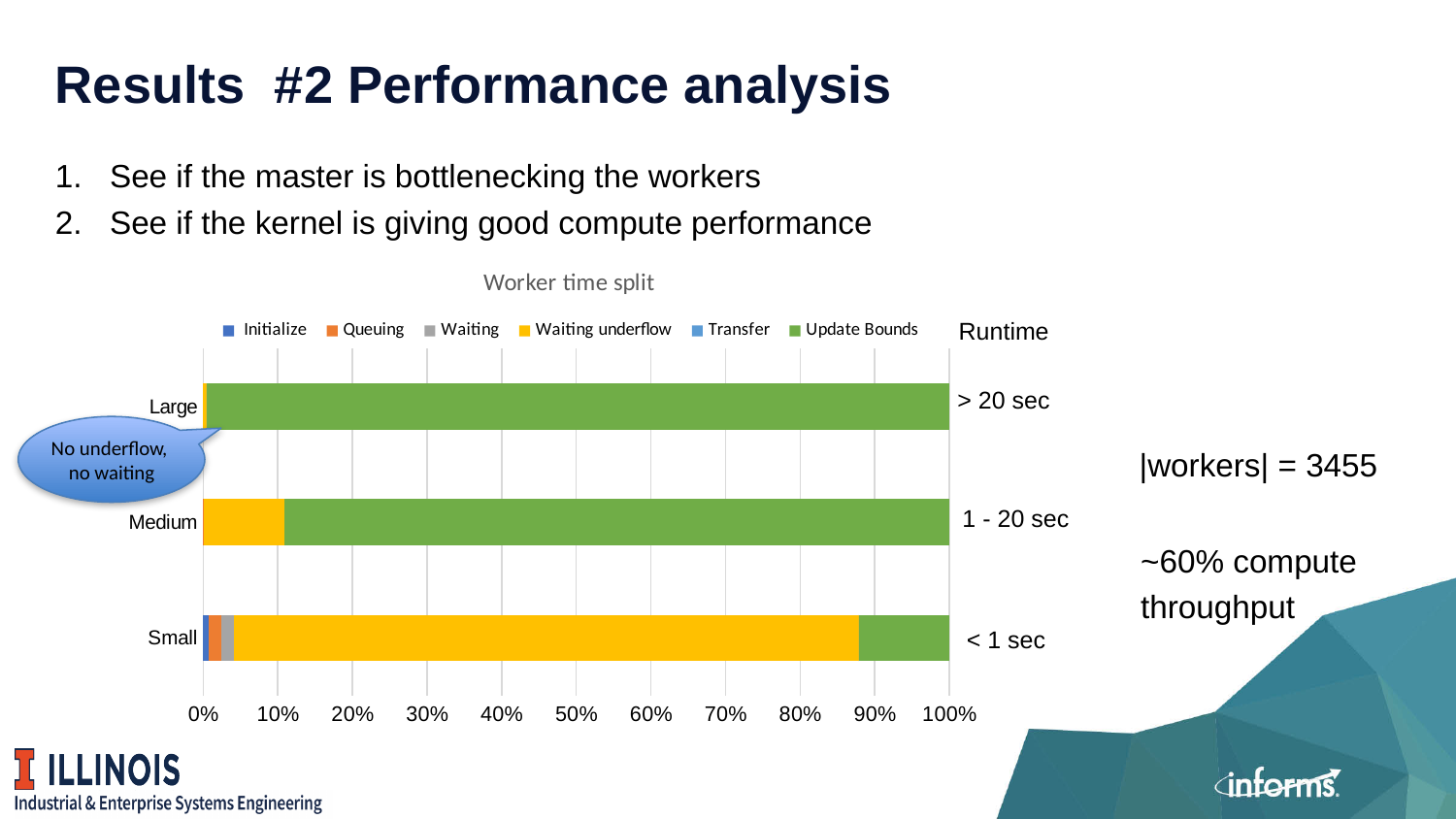
Is the Waiting underflow share for the Medium category greater or less than 20%? less Which category has the largest Update Bounds share? Large Which colour represents Update Bounds in the chart legend? Green Which category has a larger Waiting underflow share, Small or Medium? Small How many categories (bars) are plotted in the chart? 3 Which category has the smallest Update Bounds share? Small What is the title of the chart? Worker time split Is the Waiting underflow share for the Small category greater or less than 80%? greater What kind of chart is shown on the slide? Stacked bar chart How many series does the chart legend list? 6 Is the Update Bounds share for the Small category greater or less than 20%? less